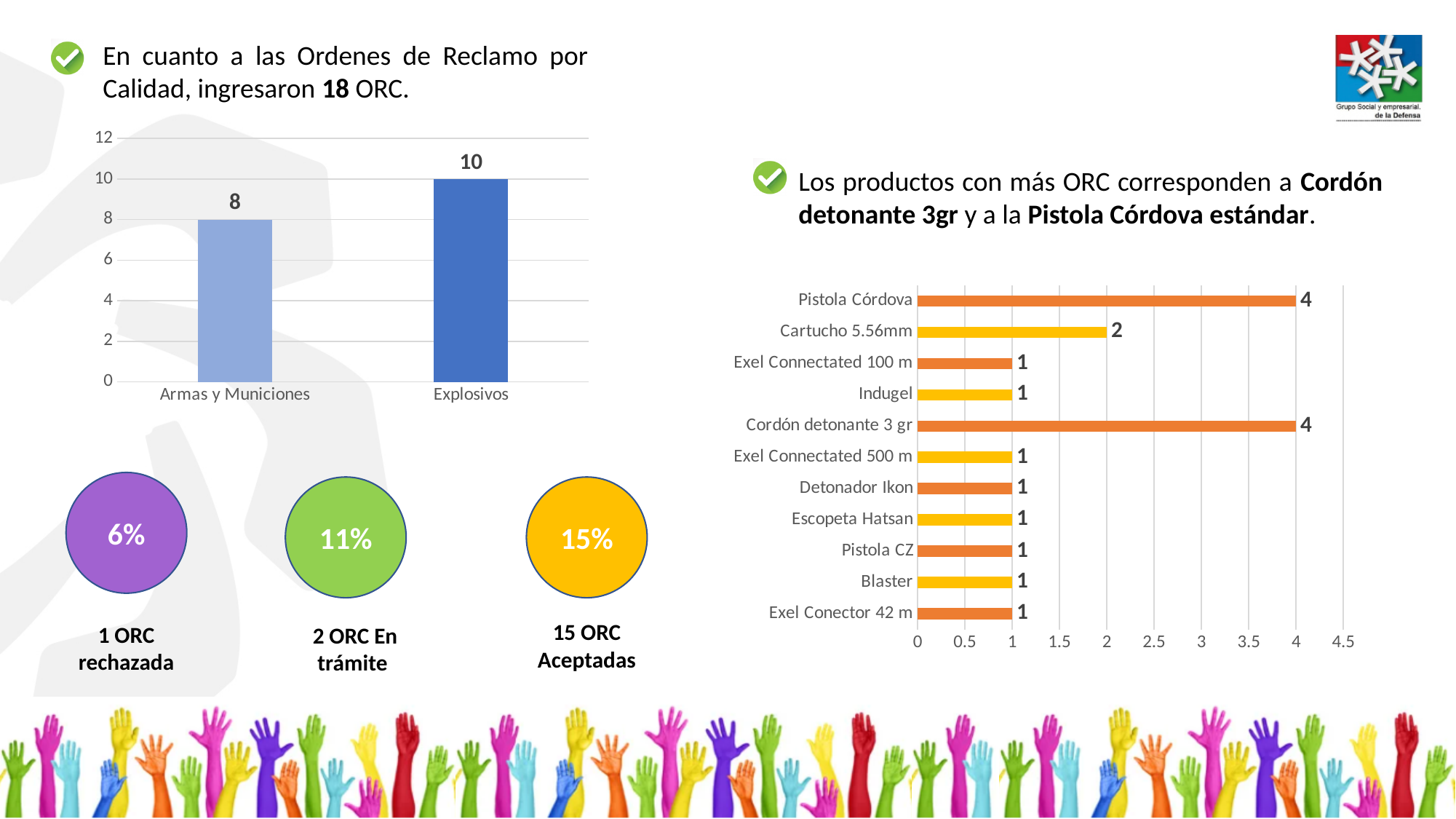
In the bar chart on the left, which category has the higher value? Explosivos In the bar chart on the left, what is the total of the two bars? 18 What type of chart is shown on the right side of the slide? Bar chart In the bar chart on the left, how many categories are shown? 2 In the bar chart on the right, which is larger, Cartucho 5.56mm or Indugel? Cartucho 5.56mm In the bar chart on the right, how many products are listed? 11 In the bar chart on the right, what is the difference between Cordón detonante 3 gr and Cartucho 5.56mm? 2 In the bar chart on the right, what is the value for Pistola Córdova? 4 In the bar chart on the right, what is the value for Cartucho 5.56mm? 2 In the bar chart on the left, what is the value for Explosivos? 10 In the bar chart on the left, what is the difference between Explosivos and Armas y Municiones? 2 In the bar chart on the left, what is the value for Armas y Municiones? 8